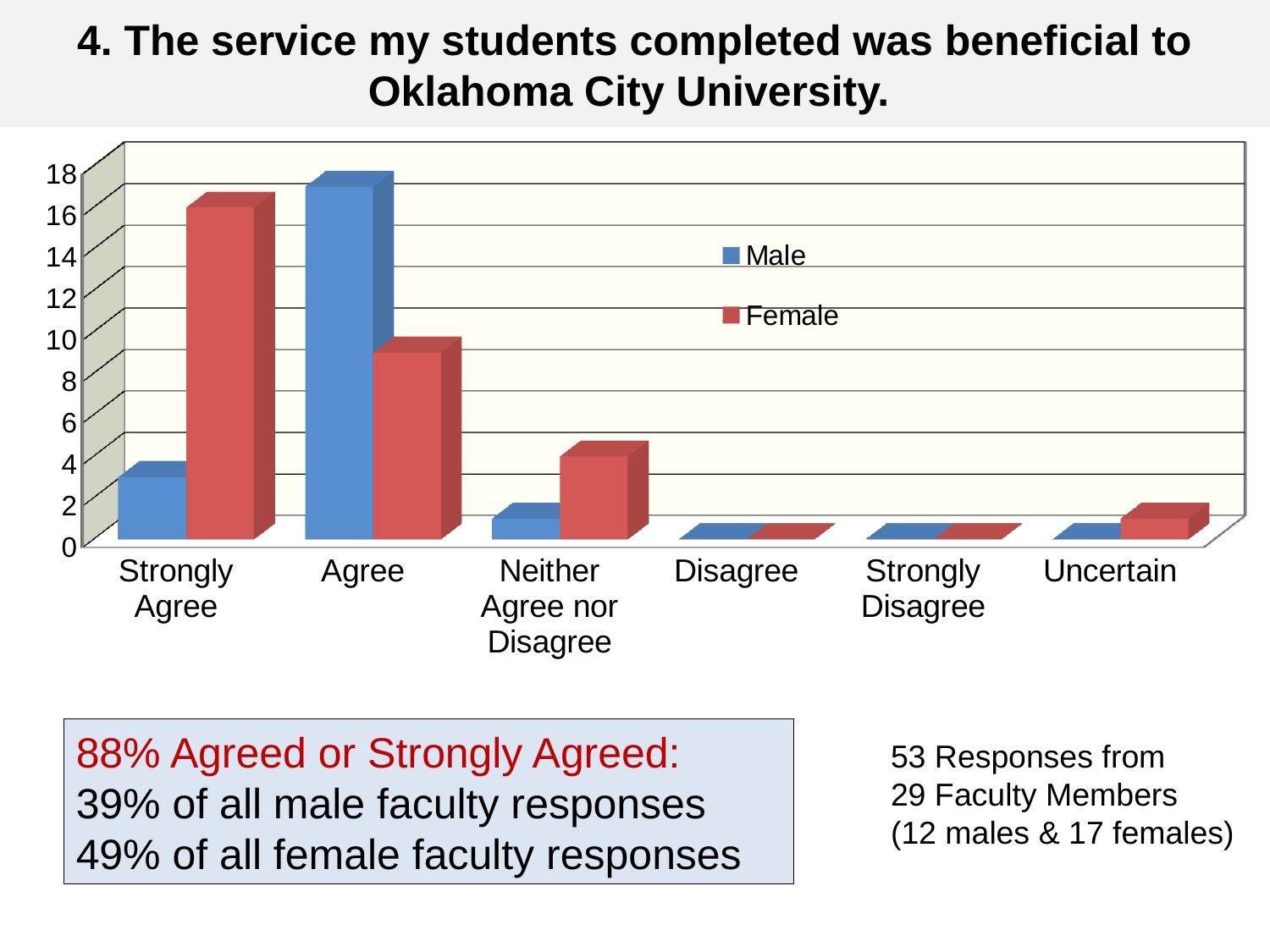
Which colour represents the Female series in the legend? red Is the Male value for Strongly Agree greater or less than 6? less What kind of chart is shown on the slide? bar chart For Strongly Agree, which series has the larger value, Male or Female? Female How many response categories are shown on the x axis? 6 Is the Female value for Agree greater or less than 12? less For Agree, which series has the larger value, Male or Female? Male Which category has the highest value for the Male series? Agree Is the Female value for Strongly Agree greater or less than 12? greater How many series does the legend list? 2 Which category has the highest value for the Female series? Strongly Agree